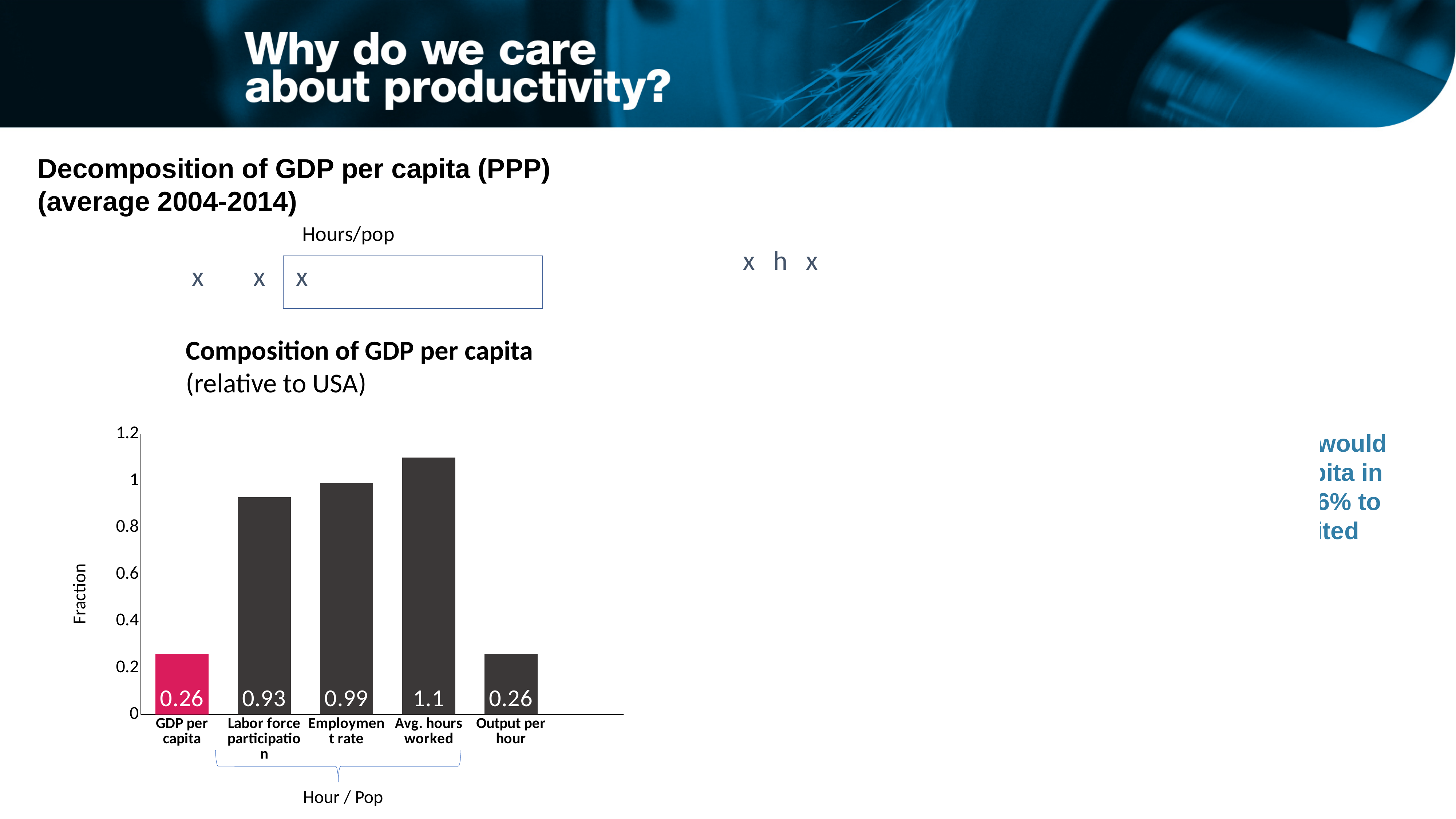
Which bar is highlighted in a different colour (pink) from the others? GDP per capita Is the value for GDP per capita greater or less than 0.4? less Which category has the highest value? Avg. hours worked What is the value for Output per hour? 0.26 What is the y-axis label of the chart? Fraction What kind of chart is shown? bar chart What is the value for Labor force participation? 0.93 What is the difference between the values for Avg. hours worked and Labor force participation? 0.17 How many categories are shown on the x axis? 5 What is the value for Employment rate? 0.99 Which is larger, the value for Employment rate or the value for Labor force participation? Employment rate What is the value for Avg. hours worked? 1.1